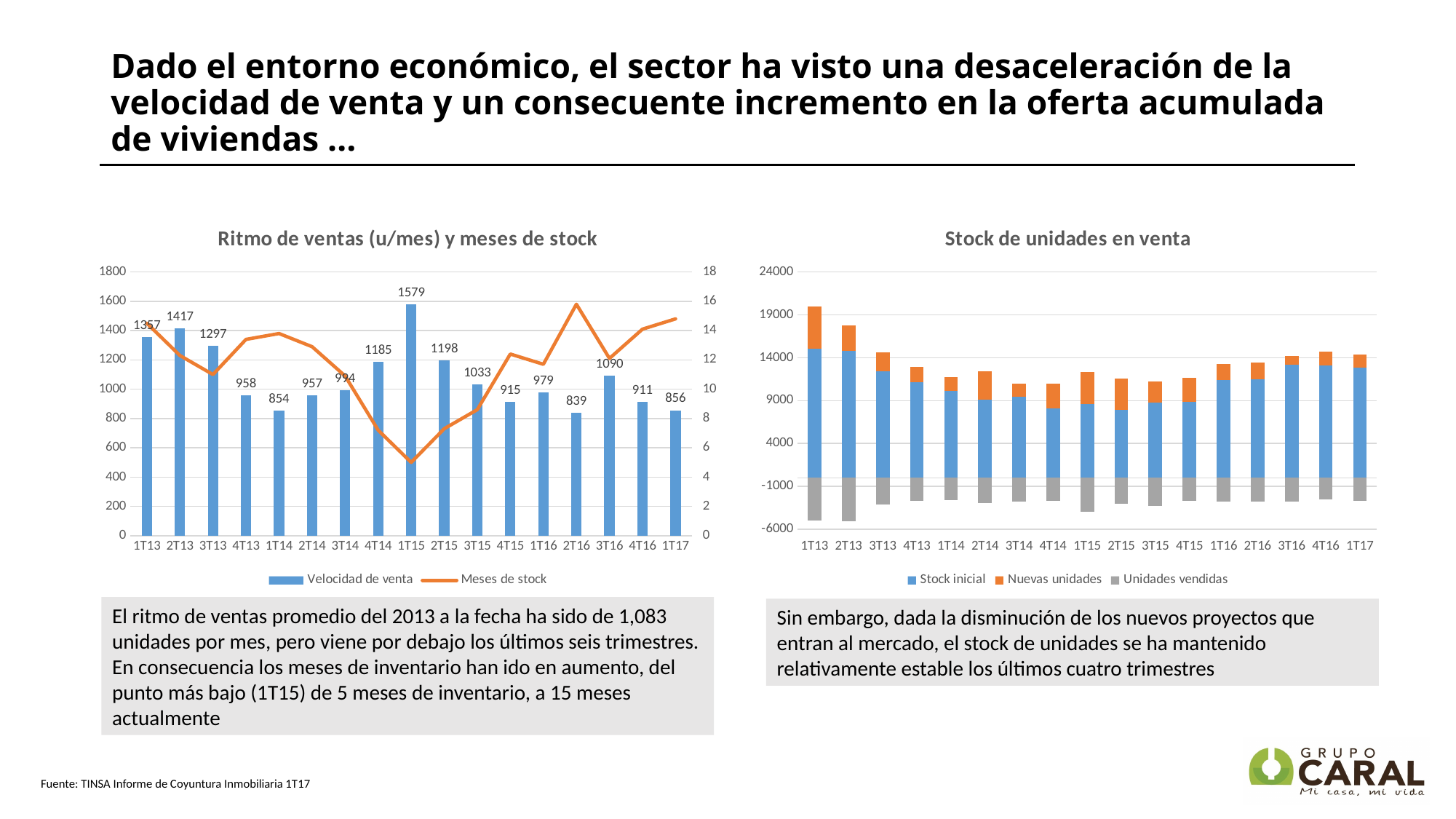
How many quarters are shown on the x axis of the chart 'Ritmo de ventas (u/mes) y meses de stock'? 17 In the chart 'Ritmo de ventas (u/mes) y meses de stock', which quarter has the lowest Velocidad de venta? 2T16 How many series does the legend of the chart 'Ritmo de ventas (u/mes) y meses de stock' list? 2 In the chart 'Ritmo de ventas (u/mes) y meses de stock', which has a higher Velocidad de venta, 4T14 or 2T15? 2T15 In the chart 'Stock de unidades en venta', is the Stock inicial value for 4T14 greater or less than 9000? less In the chart 'Ritmo de ventas (u/mes) y meses de stock', what is the difference between the Velocidad de venta for 2T13 and 1T13? 60 In the chart 'Ritmo de ventas (u/mes) y meses de stock', which quarter has the highest Velocidad de venta? 1T15 What kind of chart is 'Stock de unidades en venta'? Stacked bar chart In the chart 'Ritmo de ventas (u/mes) y meses de stock', what is the Velocidad de venta value for 1T15? 1579 In the chart 'Ritmo de ventas (u/mes) y meses de stock', what is the Velocidad de venta value for 1T17? 856 How many series does the legend of the chart 'Stock de unidades en venta' list? 3 What are the legend entries of the chart 'Stock de unidades en venta'? Stock inicial, Nuevas unidades, Unidades vendidas